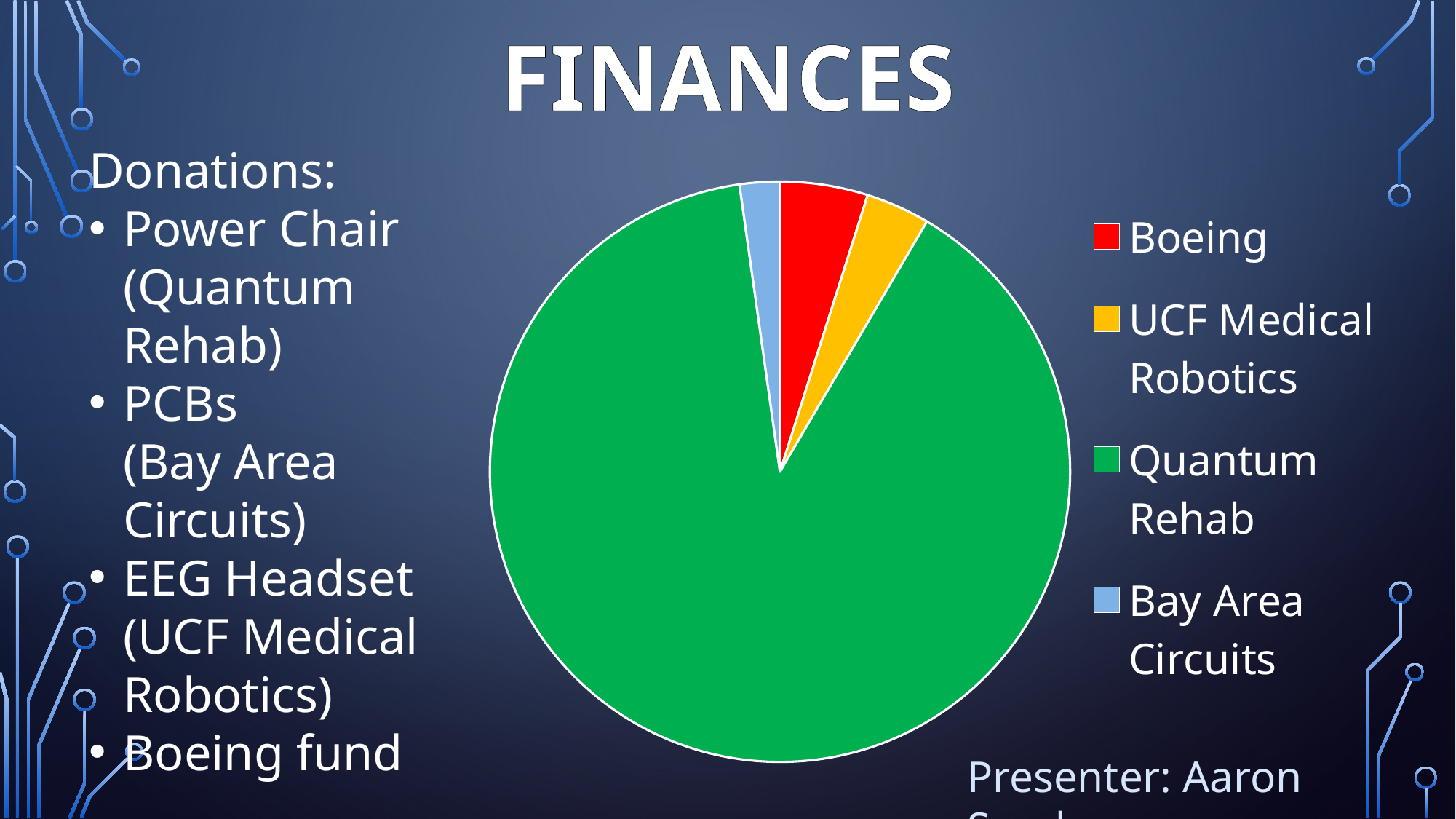
Which slice is larger, Boeing or Bay Area Circuits? Boeing Which category has the smallest slice of the pie chart? Bay Area Circuits Which slice is larger, UCF Medical Robotics or Bay Area Circuits? UCF Medical Robotics Which slice is larger, Quantum Rehab or Boeing? Quantum Rehab How many slices does the pie chart have? 4 What colour is the Boeing slice in the pie chart? red What kind of chart is shown on the slide? pie chart Which category is shown in green in the pie chart? Quantum Rehab Which category has the largest slice of the pie chart? Quantum Rehab How many entries does the legend of the pie chart list? 4 Does Quantum Rehab account for more or less than half of the pie chart? more